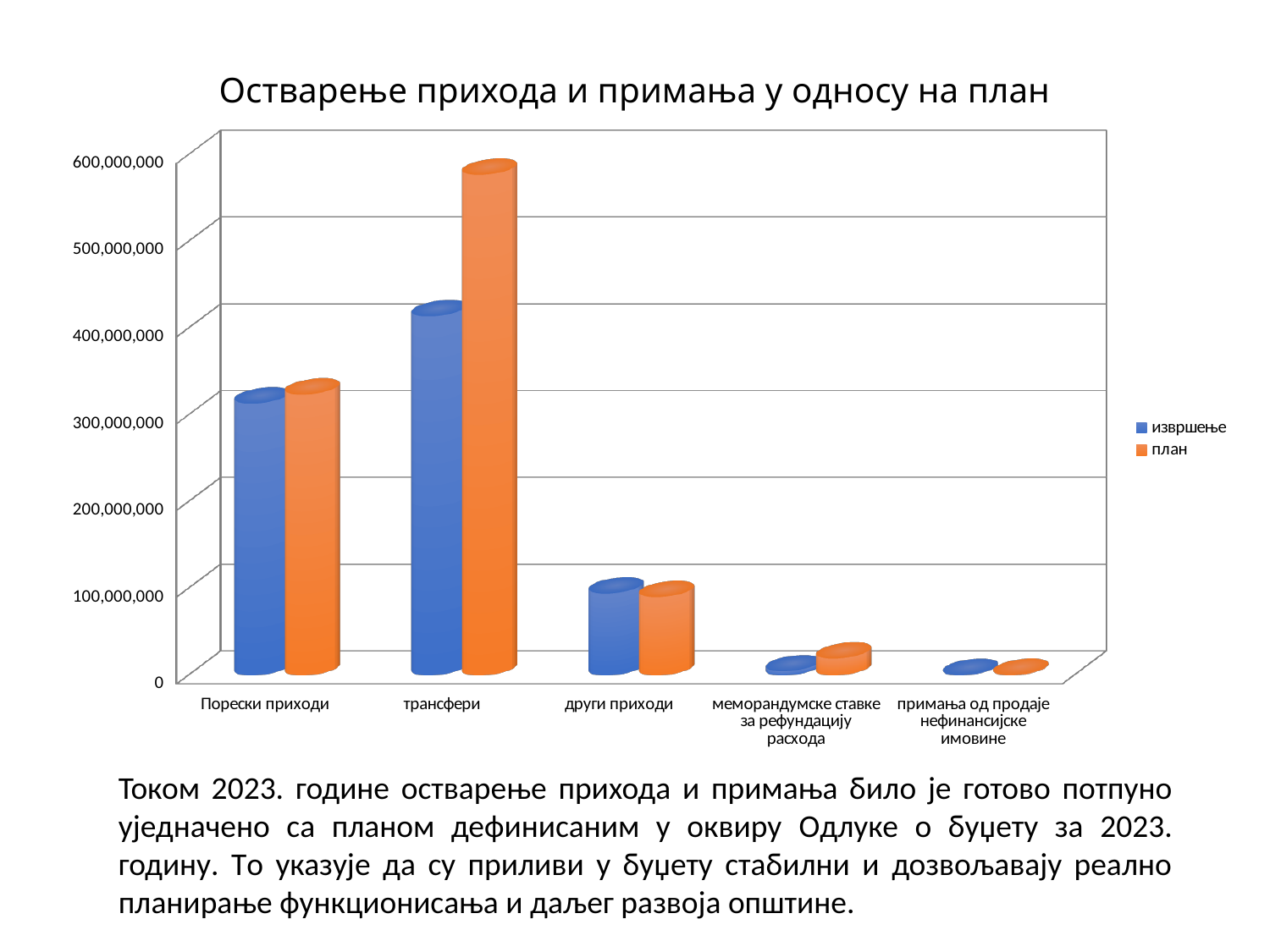
For трансфери, which is larger: извршење or план? план What is the title of the chart? Остварење прихода и примања у односу на план Is the извршење value for трансфери greater or less than 500,000,000? less Is the план value for други приходи greater or less than 200,000,000? less Which category has the highest value for план? трансфери How many categories are shown on the x axis? 5 Is the план value for трансфери greater or less than 500,000,000? greater What kind of chart is shown on the slide? bar chart How many series does the legend list? 2 Which category has the lowest value for план? примања од продаје нефинансијске имовине Which category has the highest value for извршење? трансфери